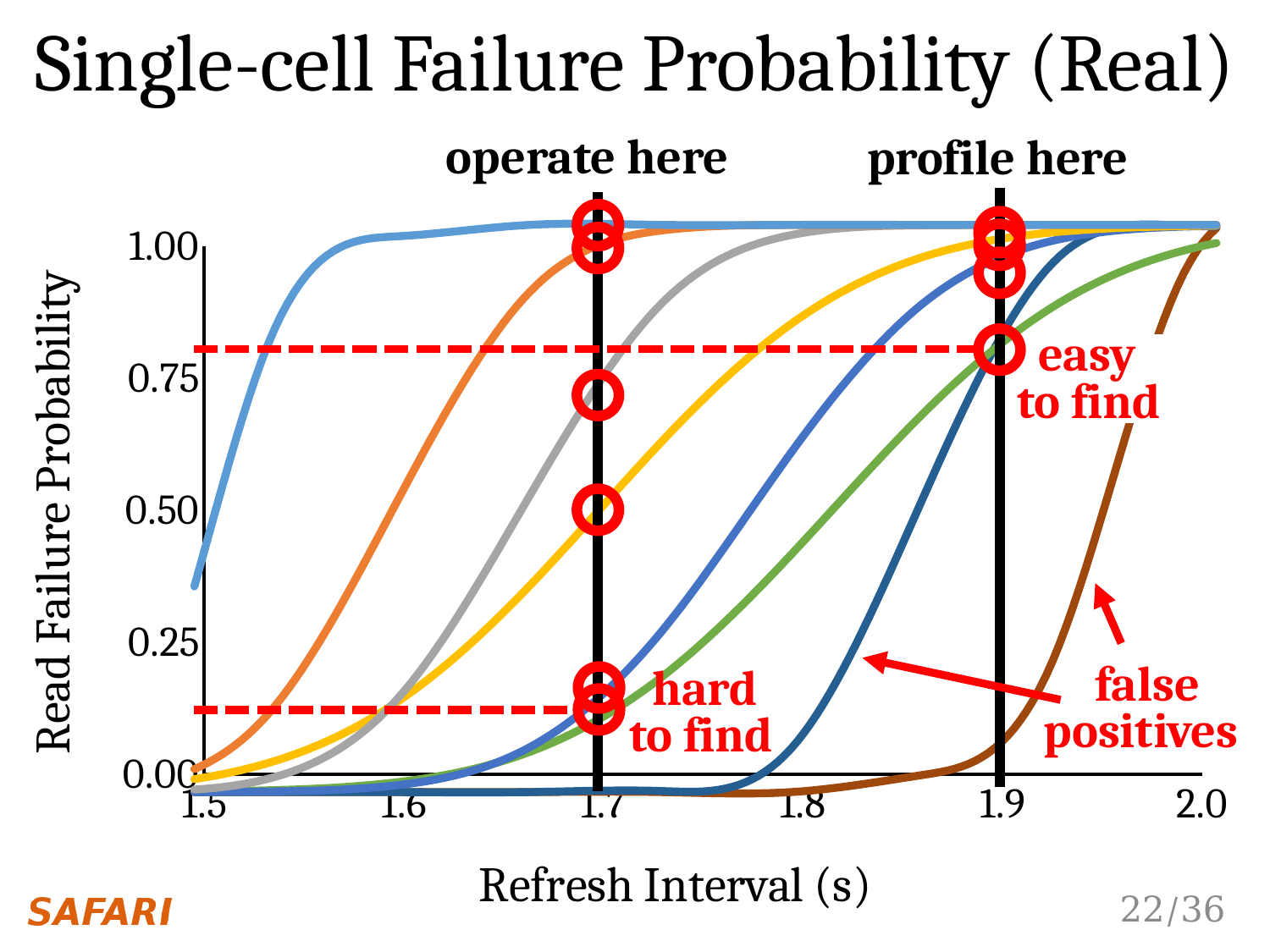
What kind of chart is shown on the slide? Line chart At what refresh interval is the vertical line labelled "profile here" drawn? 1.9 At a refresh interval of 1.7, which curve has the higher read failure probability, the orange curve or the green curve? The orange curve At what refresh interval is the vertical line labelled "operate here" drawn? 1.7 What is the title of the chart on the slide? Single-cell Failure Probability (Real) How many tick labels are shown on the x axis of the chart? 6 Is the value of the light blue curve at a refresh interval of 1.6 greater or less than 0.75? greater Is the value of the orange curve at a refresh interval of 1.7 greater or less than 0.75? greater Is the value of the brown curve at a refresh interval of 1.9 greater or less than 0.25? less Do the curves rise or fall as the refresh interval increases along the x axis? Rise What is the label of the x axis of the chart? Refresh Interval (s) Which curve reaches a read failure probability of 1.00 at the smallest refresh interval? The light blue curve